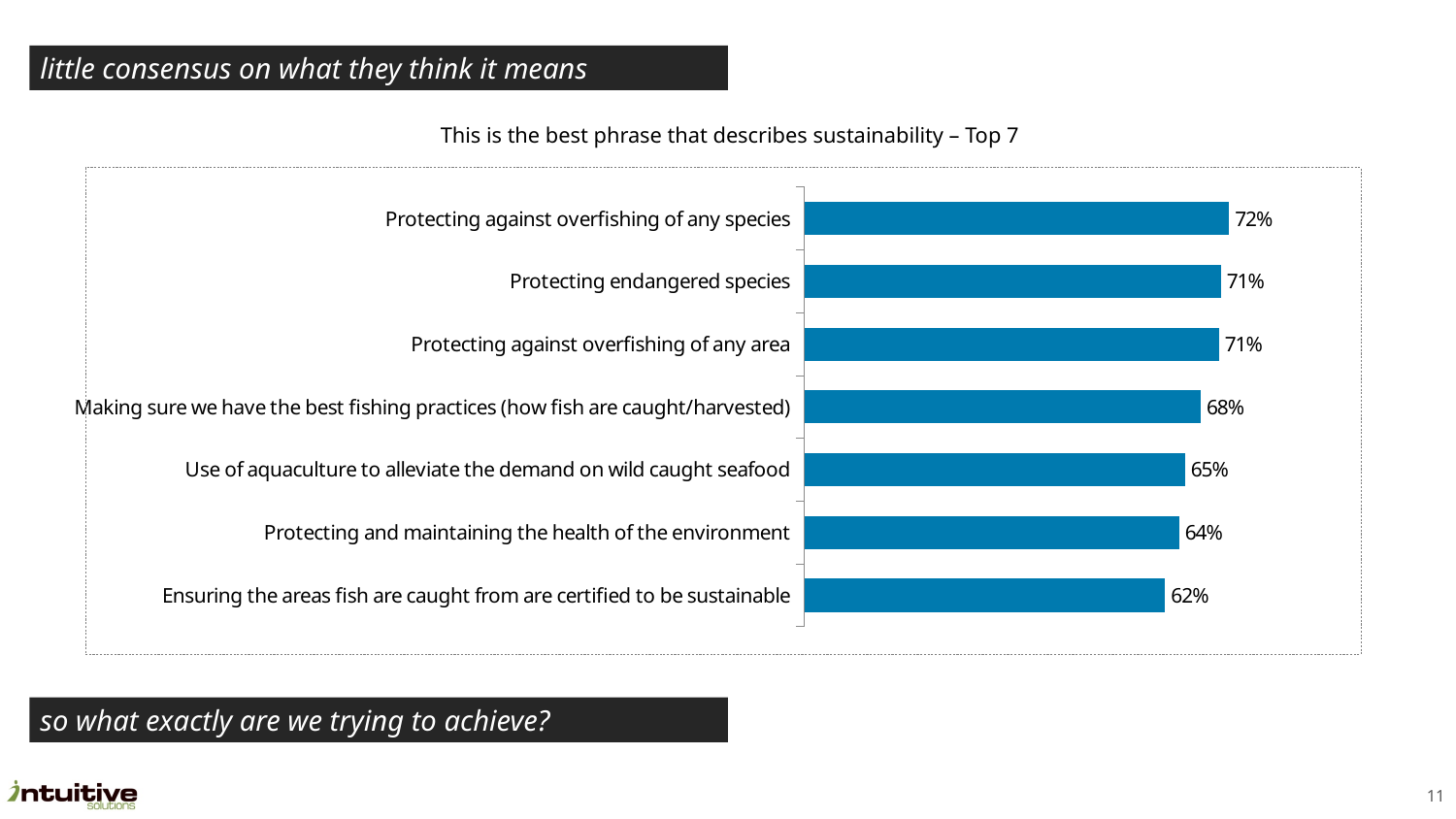
What is the difference between the highest value (72%) and the lowest value (62%) in the chart? 10 percentage points What is the title of the chart? This is the best phrase that describes sustainability – Top 7 What is the value for 'Ensuring the areas fish are caught from are certified to be sustainable'? 62% What type of chart is shown on the slide? Bar chart Which is larger: the value for 'Protecting endangered species' or the value for 'Protecting and maintaining the health of the environment'? Protecting endangered species What percentage chose 'Protecting against overfishing of any species' as the best phrase describing sustainability? 72% Which phrase has the lowest percentage in the chart? Ensuring the areas fish are caught from are certified to be sustainable What is the value for 'Making sure we have the best fishing practices (how fish are caught/harvested)'? 68% What is the difference between 'Making sure we have the best fishing practices' (68%) and 'Protecting and maintaining the health of the environment' (64%)? 4 percentage points How many phrases (bars) are shown in the chart? 7 Which phrase has the highest percentage in the chart? Protecting against overfishing of any species What is the value for 'Use of aquaculture to alleviate the demand on wild caught seafood'? 65%